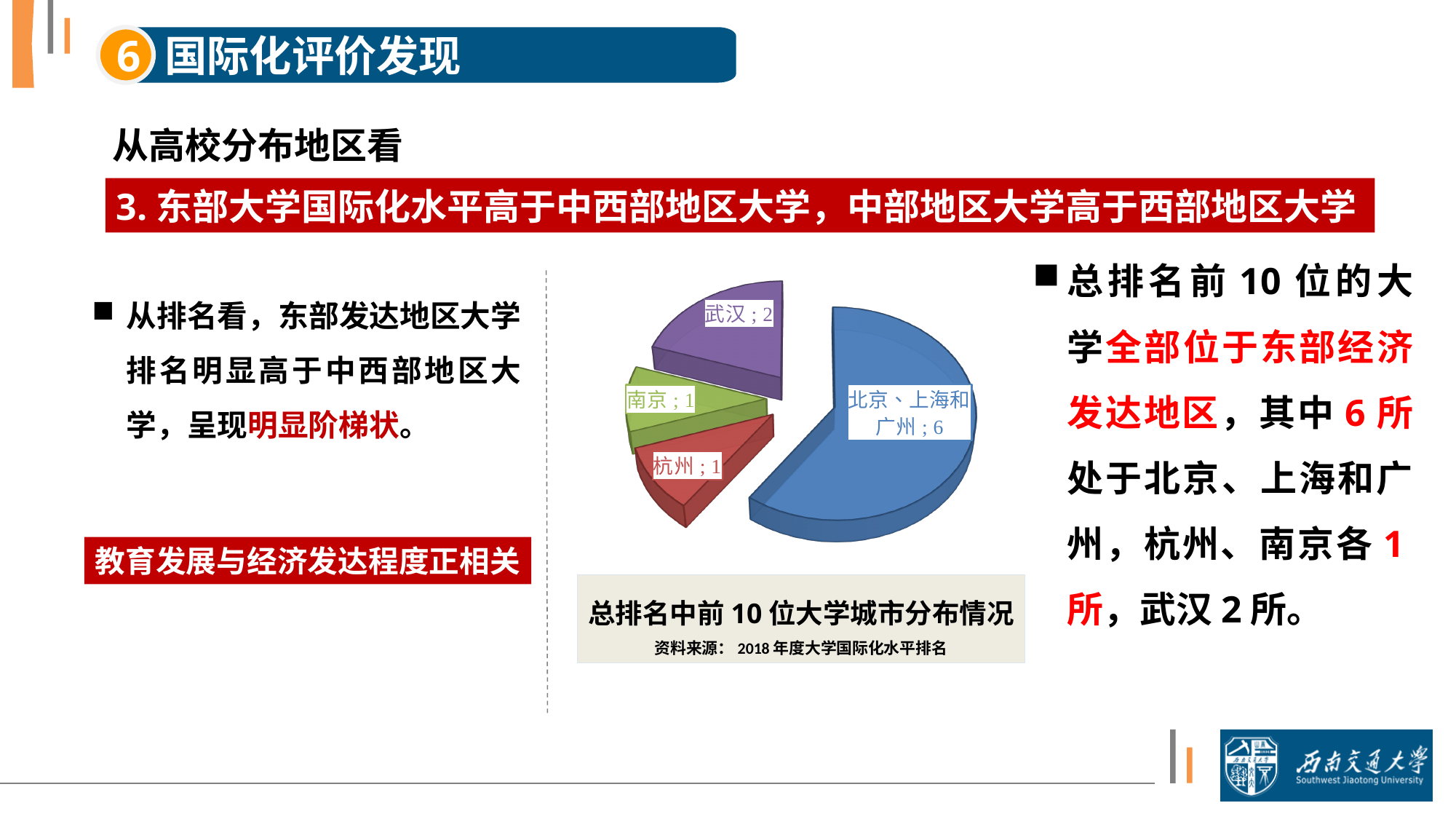
What is the value for 南京 in the pie chart? 1 Which is larger, the value for 武汉 or the value for 南京? 武汉 What is the value for 武汉 in the pie chart? 2 How many slices does the pie chart have? 4 What kind of chart is shown on the slide? pie chart What is the difference between the values for 北京、上海和广州 and 武汉? 4 What is the value for 北京、上海和广州 in the pie chart? 6 What is the title of the pie chart? 总排名中前10位大学城市分布情况 Which category has the largest slice in the pie chart? 北京、上海和广州 What share of the pie does 武汉 represent? 20% What share of the pie does 北京、上海和广州 represent? 60% What is the value for 杭州 in the pie chart? 1